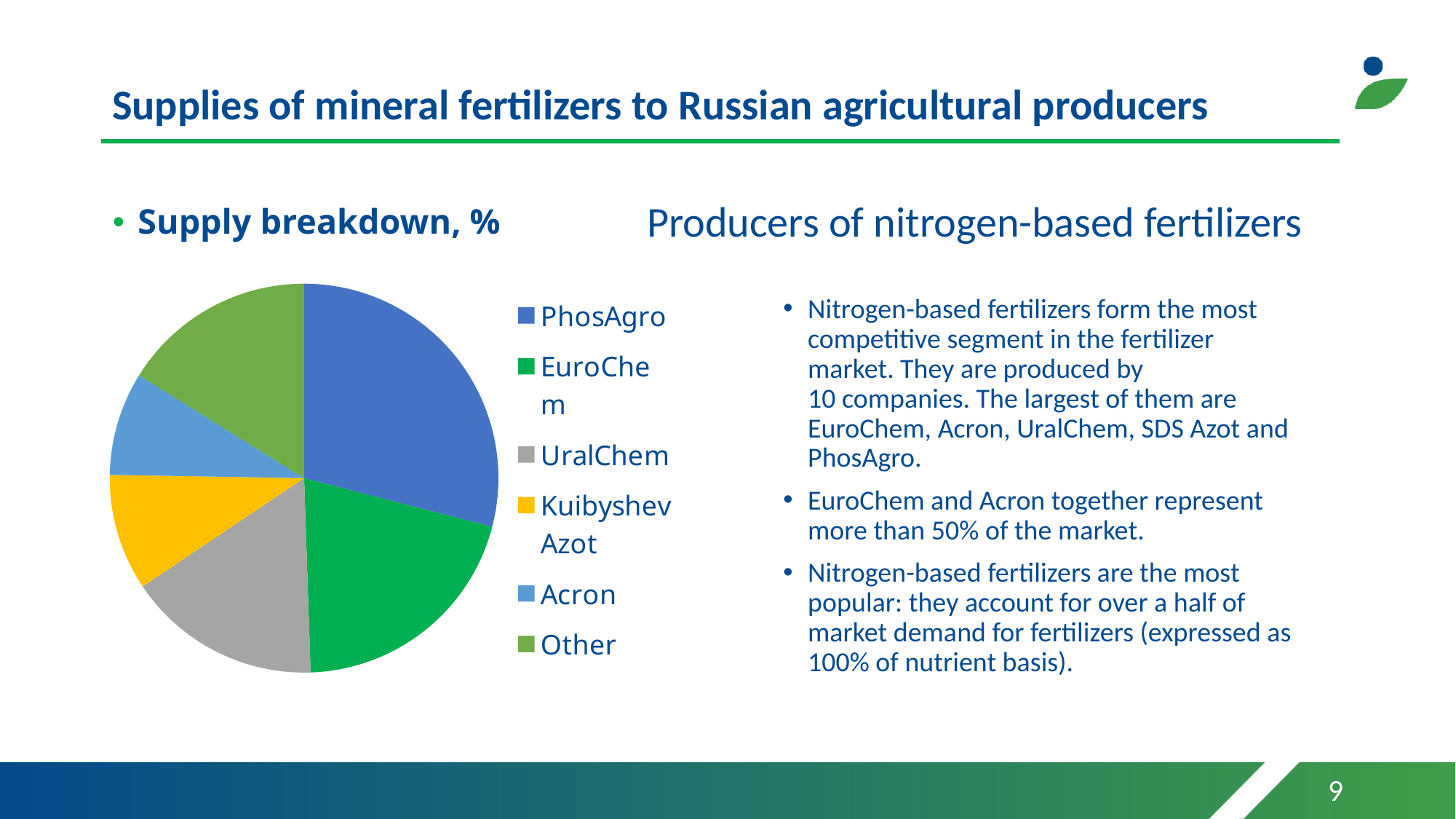
Which slice is larger in the pie chart, Other or Acron? Other What kind of chart is shown on the slide? pie chart Which slice is larger in the pie chart, PhosAgro or Acron? PhosAgro How many entries does the pie chart legend list? 6 What colour is the PhosAgro slice in the pie chart? blue Which slice is larger in the pie chart, UralChem or Acron? UralChem What is the title of the pie chart? Supply breakdown, % How many slices does the pie chart have? 6 Which company has the largest slice in the pie chart? PhosAgro